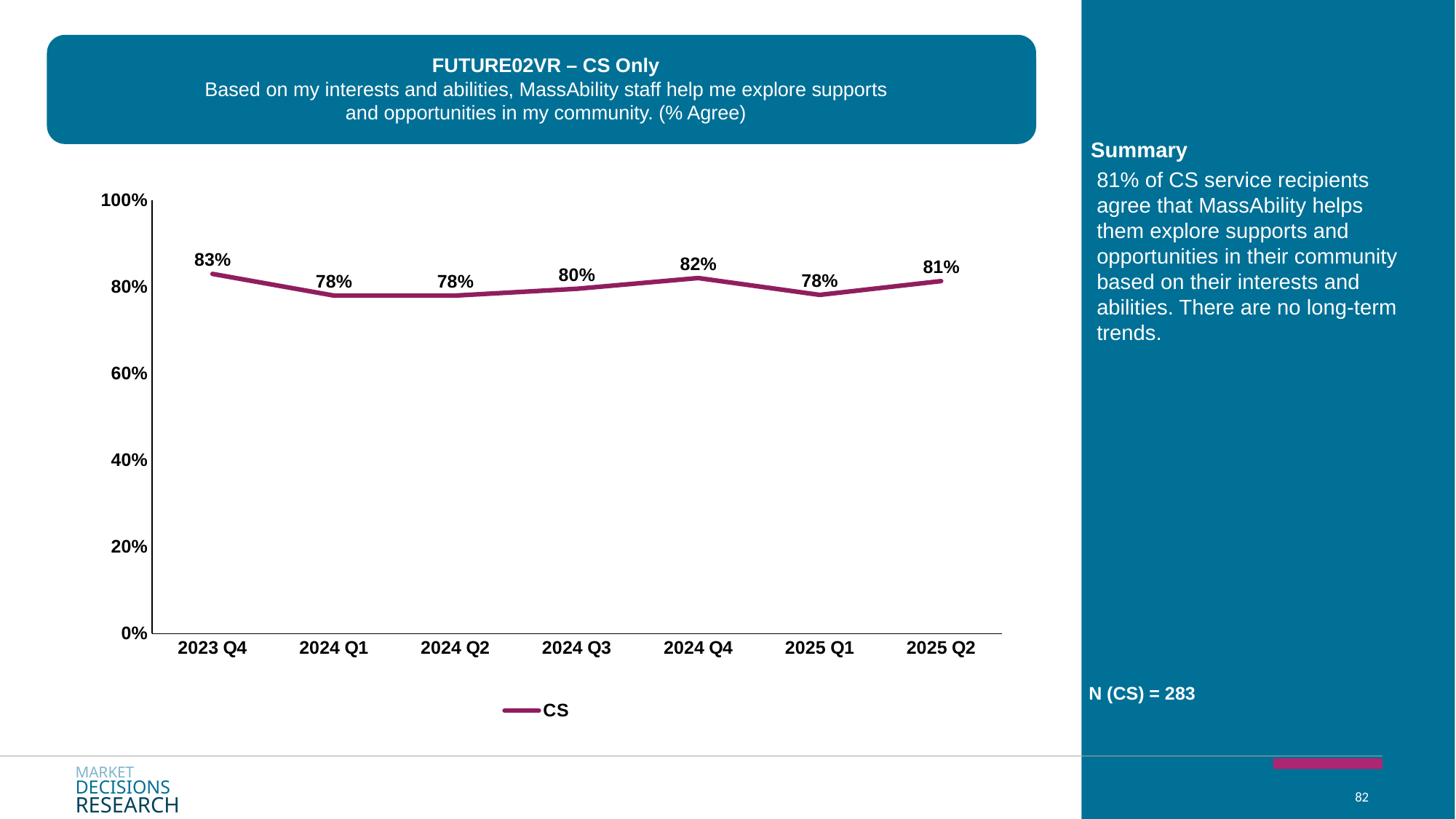
Is the value for 2025 Q1 greater or less than 80%? less What kind of chart is shown? line chart What is the value for 2023 Q4? 83% What is the value for 2024 Q3? 80% What is the value for 2024 Q4? 82% Which is larger, the value for 2024 Q3 or the value for 2024 Q4? 2024 Q4 What is the difference between the values for 2023 Q4 and 2024 Q1? 5% What is the value for 2025 Q2? 81% Which quarter has the highest value? 2023 Q4 What series name does the legend show? CS What is the difference between the values for 2024 Q4 and 2025 Q1? 4% How many quarters are plotted on the x axis? 7